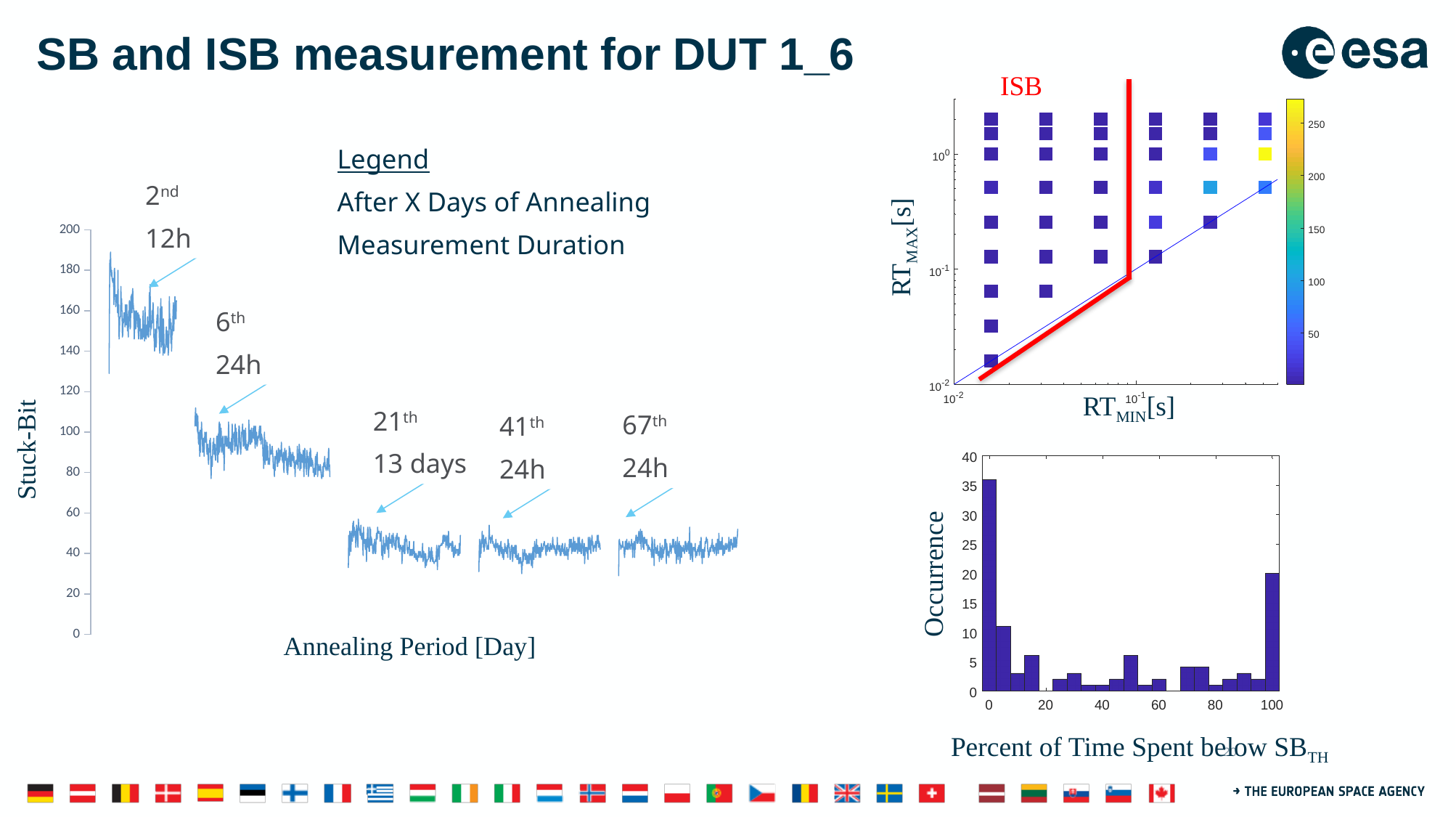
What is the y-axis label of the chart on the left of the slide? Stuck-Bit What kind of chart is the bottom-right chart with the x-axis 'Percent of Time Spent below SB_TH'? bar chart In the bottom-right Occurrence chart, at which x-axis value is the tallest bar located? 0 In the Stuck-Bit chart on the left, are the values of the 2nd-day segment greater or less than 120? greater In the bottom-right Occurrence chart, is the bar at 100 greater or less than 15? greater In the Stuck-Bit chart on the left, how many measurement segments are labelled? 5 In the Stuck-Bit chart on the left, do the Stuck-Bit values rise or fall as the annealing period increases? fall In the Stuck-Bit chart on the left, what is the measurement duration of the 21st-day segment? 13 days In the Stuck-Bit chart on the left, what is the measurement duration of the 2nd-day segment? 12h In the Stuck-Bit chart on the left, are the values of the 67th-day segment greater or less than 60? less What is the x-axis label of the chart on the left of the slide? Annealing Period [Day]